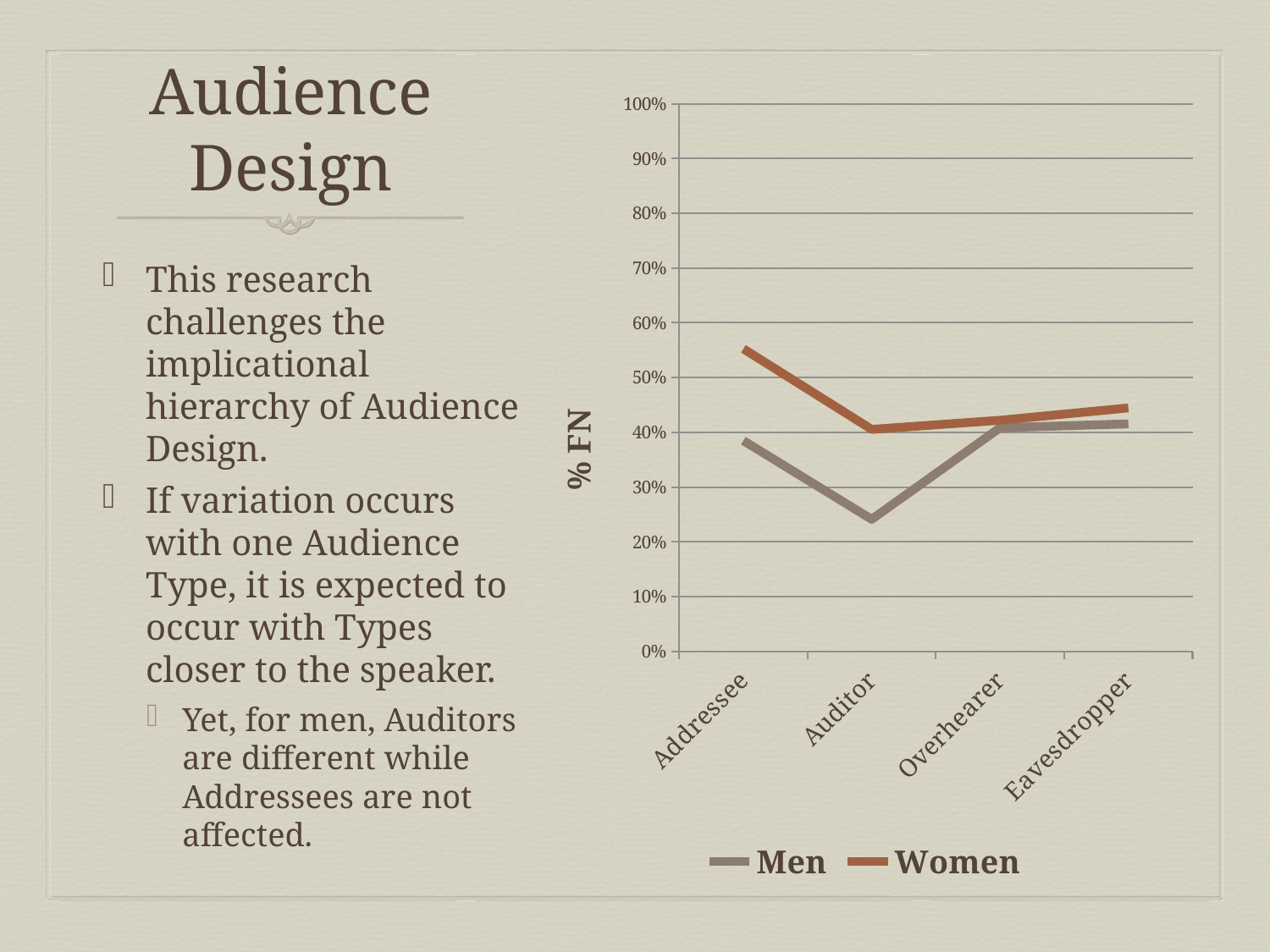
How many series does the legend list? 2 Is the value for Men at Auditor greater or less than 30%? less At Addressee, which series has the higher value, Men or Women? Women For which audience type is the Women series highest? Addressee What is the label on the y axis? % FN Does the Men series rise or fall from Auditor to Overhearer? rise For which audience type is the Men series lowest? Auditor What kind of chart is shown on the slide? line chart Is the value for Men at Addressee greater or less than 30%? greater How many audience types are shown on the x axis? 4 Is the value for Women at Addressee greater or less than 50%? greater Which series are listed in the legend? Men and Women